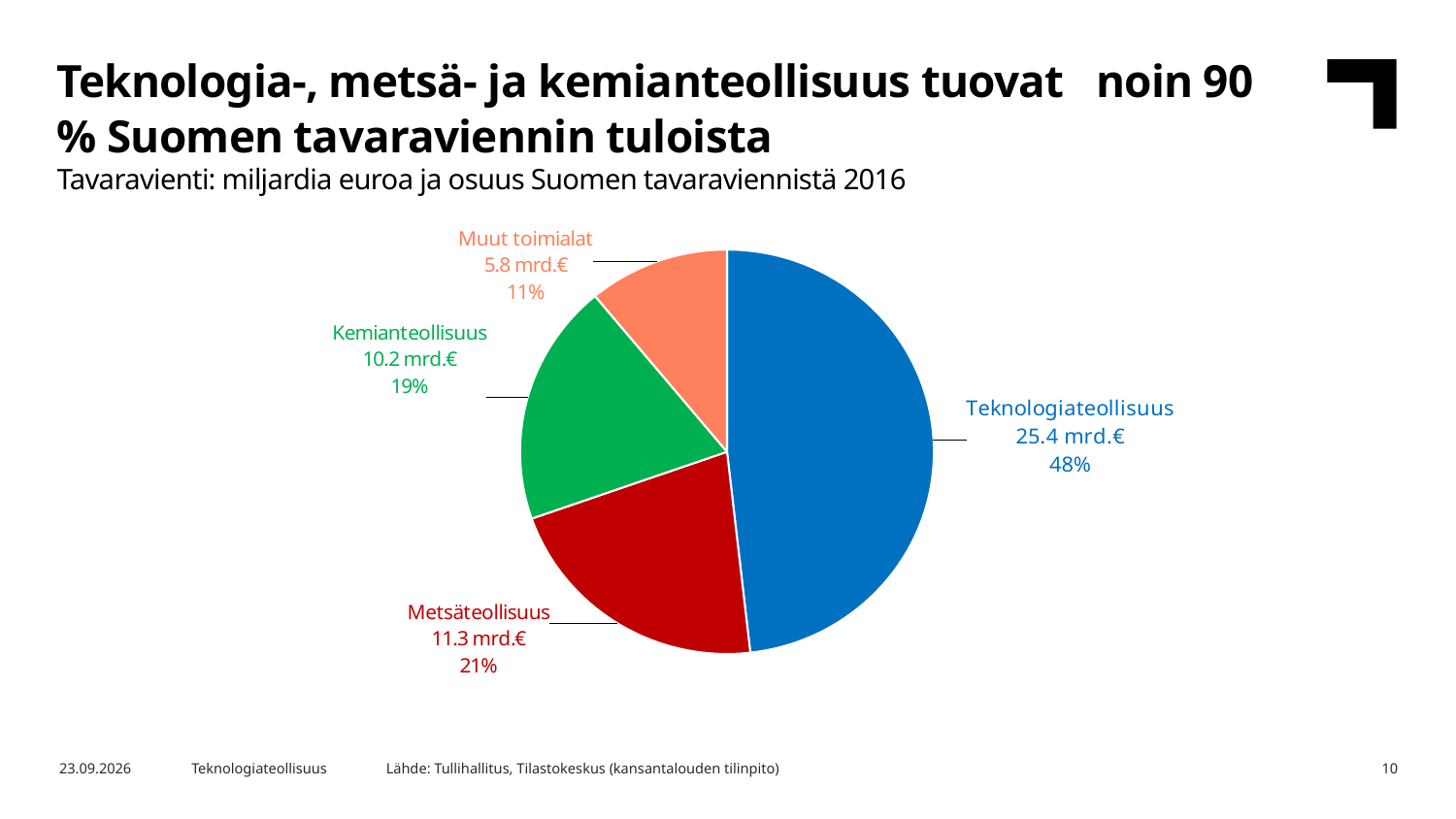
What is the value for Kemianteollisuus? 10.2 mrd.€ What is the difference in mrd.€ between Teknologiateollisuus and Metsäteollisuus? 14.1 mrd.€ What colour is the Teknologiateollisuus slice? Blue How many slices does the pie chart have? 4 What share of the pie does Muut toimialat represent? 11% Which category has the largest slice? Teknologiateollisuus What share of the pie does Metsäteollisuus represent? 21% Which category has the smallest slice? Muut toimialat What is the difference in percentage points between Kemianteollisuus and Muut toimialat? 8 percentage points What kind of chart is shown on the slide? Pie chart Which is larger, Kemianteollisuus or Metsäteollisuus? Metsäteollisuus What is the value for Teknologiateollisuus? 25.4 mrd.€